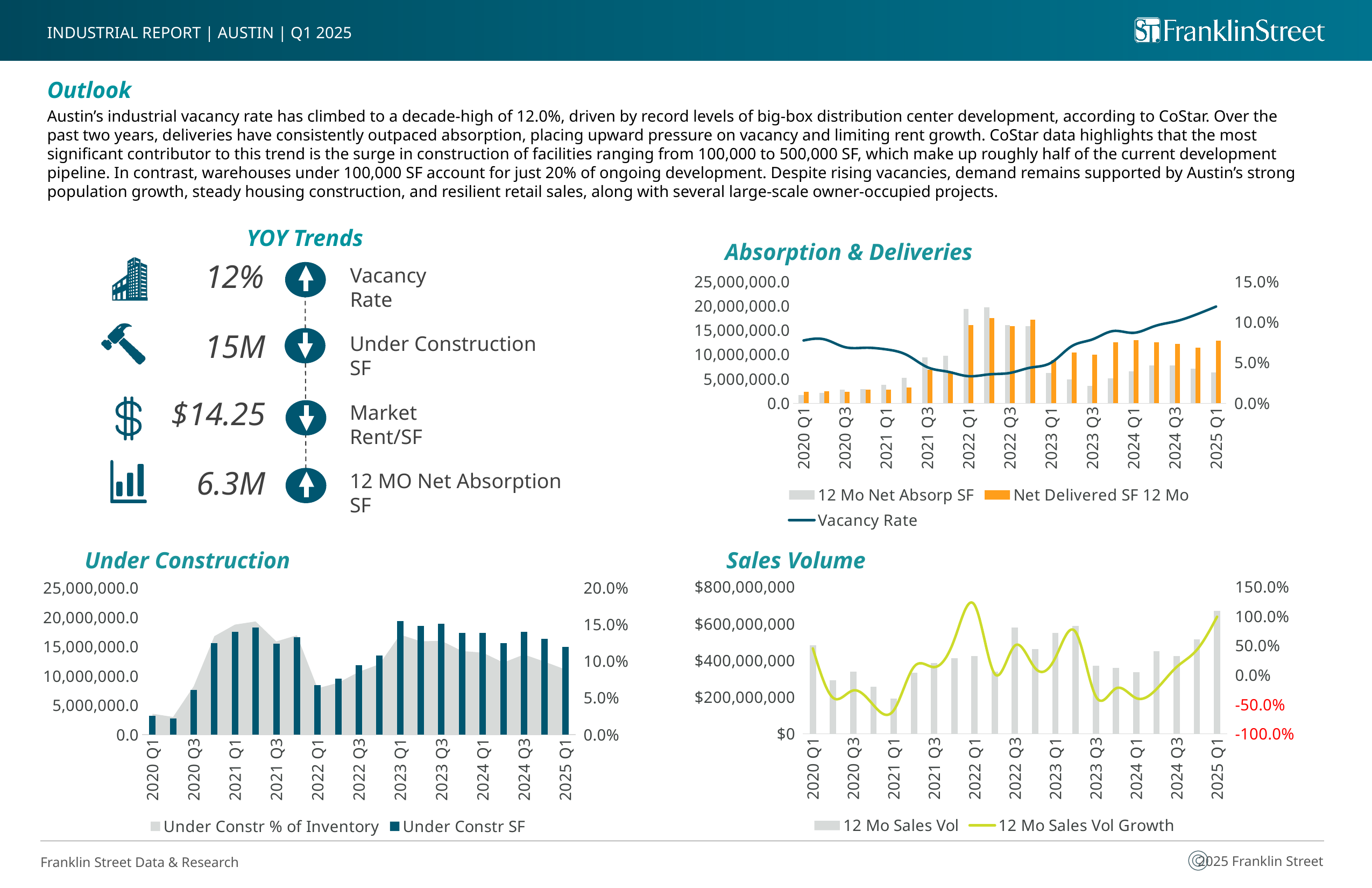
In the Absorption & Deliveries chart, is the Net Delivered SF 12 Mo value at 2022 Q1 greater or less than 15,000,000.0? greater What kind of chart is the Sales Volume chart? A bar chart combined with a line chart In the Absorption & Deliveries chart, does the Vacancy Rate line rise or fall from 2022 Q1 to 2025 Q1? rise In the Under Construction chart, is the Under Constr SF value at 2023 Q1 greater or less than 15,000,000.0? greater In the Sales Volume chart, which quarter has the highest 12 Mo Sales Vol bar? 2025 Q1 In the Absorption & Deliveries chart, how many series does the legend list? 3 In the Under Construction chart, is the Under Constr SF value at 2020 Q1 greater or less than 5,000,000.0? less In the Under Construction chart, how many series does the legend list? 2 In the Under Construction chart, do the Under Constr SF bars rise or fall from 2023 Q1 to 2025 Q1? fall